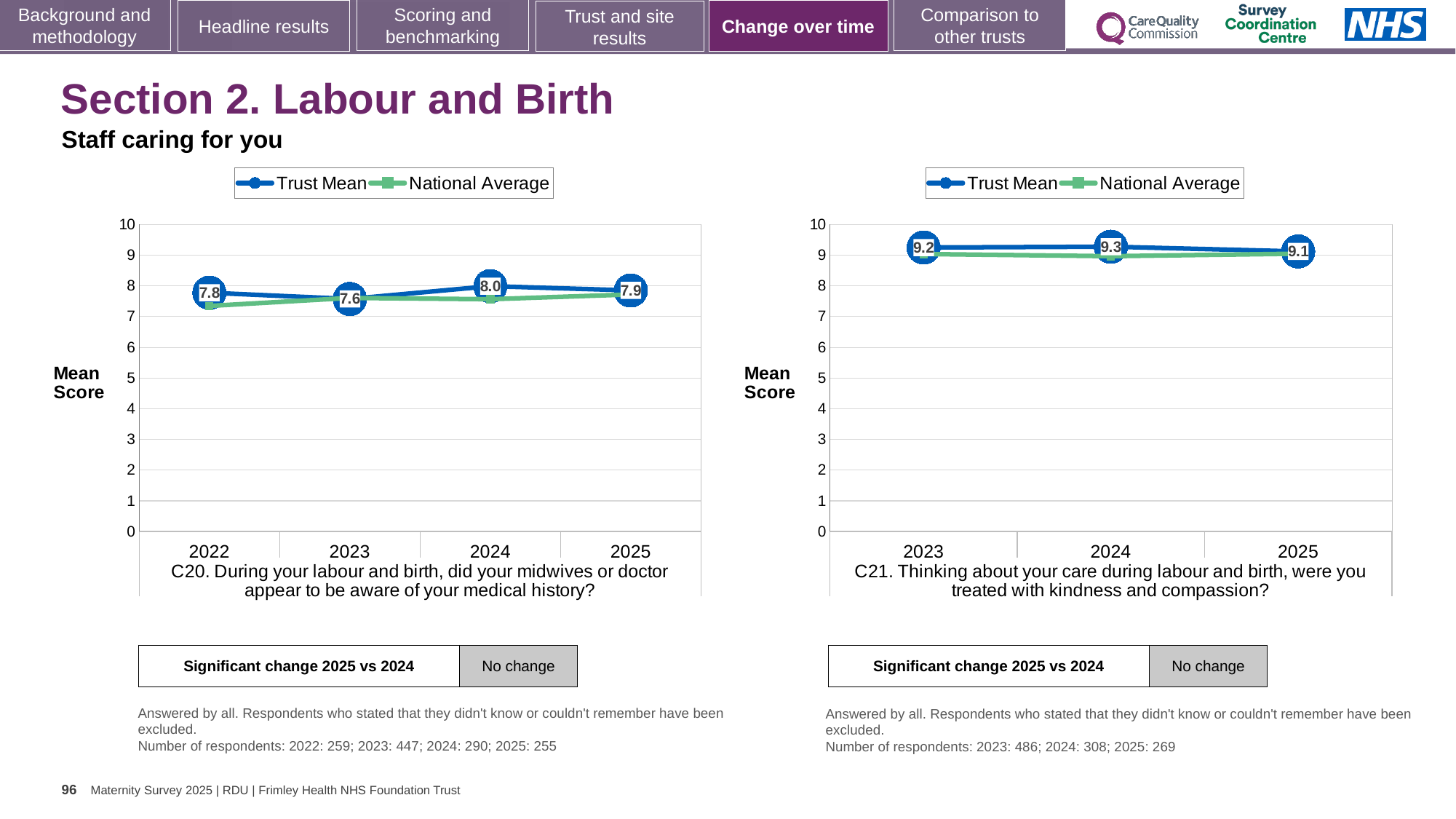
In the C21 chart (right), does the Trust Mean rise or fall from 2024 to 2025? Fall How many series does the legend of the C20 chart (left) list? 2 In the C21 chart (right), what is the Trust Mean for 2025? 9.1 In the C20 chart (left), which year has the lowest Trust Mean? 2023 In the C21 chart (right), which year has the highest Trust Mean? 2024 In the C20 chart (left), what is the difference between the Trust Mean for 2024 and 2023? 0.4 In the C20 chart (left), is the National Average for 2022 greater or less than 8? less In the C20 chart (left), what is the Trust Mean for 2022? 7.8 How many years are shown on the x axis of the C21 chart (right)? 3 In the C21 chart (right), is the Trust Mean higher in 2023 or 2025? 2023 In the C20 chart (left), what is the Trust Mean for 2024? 8.0 What type of chart is the C20 chart (left)? Line chart